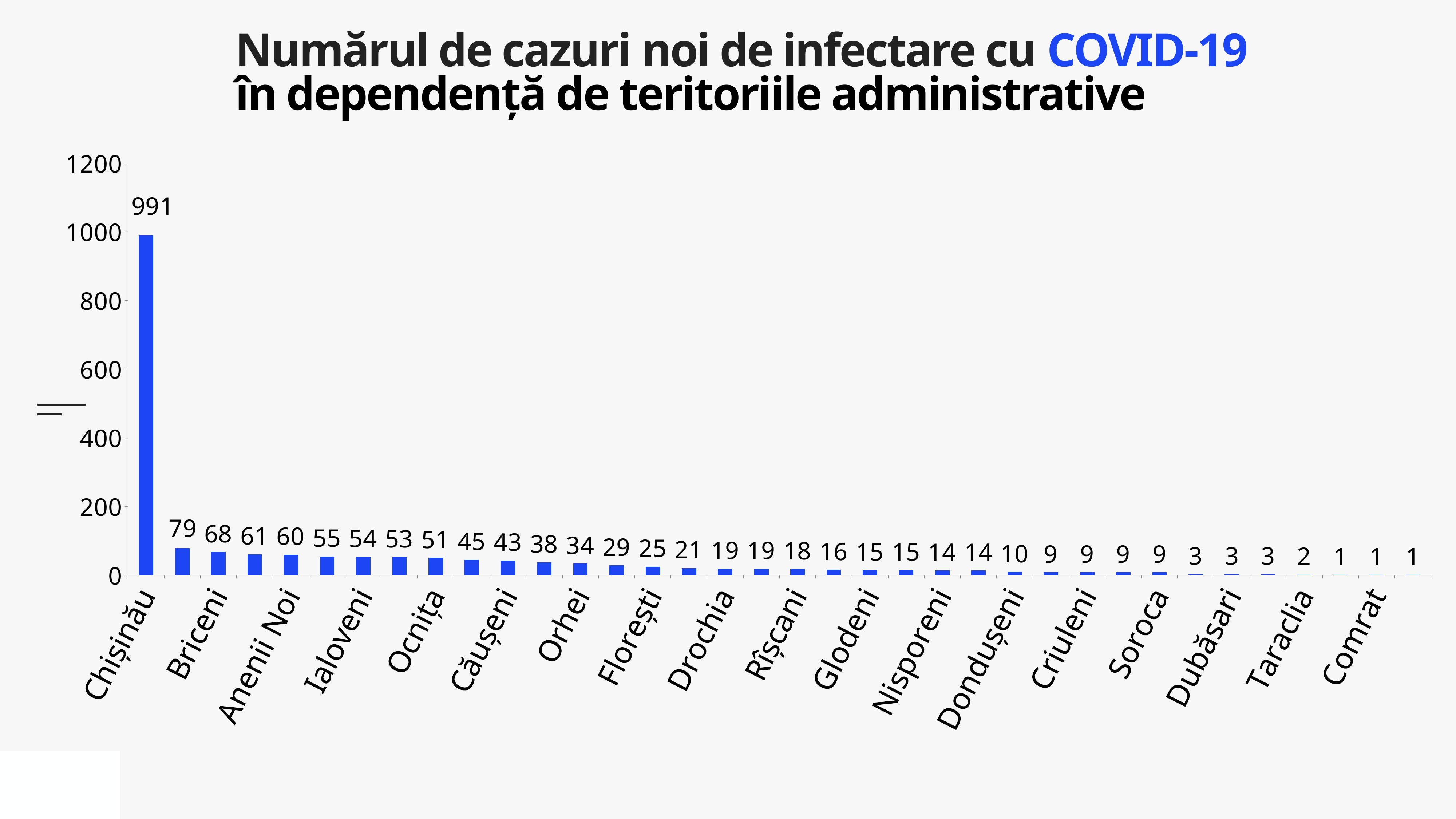
Which has more new cases, Drochia or Nisporeni? Drochia How many new cases are shown for Drochia? 19 How many new cases are shown for Glodeni? 15 What kind of chart is shown on the slide? bar chart How many new cases are shown for Chișinău? 991 How many new cases are shown for Criuleni? 9 What is the difference between the number of cases in Chișinău and in Glodeni? 976 Which territory has the highest number of new COVID-19 cases? Chișinău Is the value for Chișinău greater or less than 800? greater How many new cases are shown for Dubăsari? 3 Do the values rise or fall from left to right along the x axis? fall How many new cases are shown for Comrat? 1